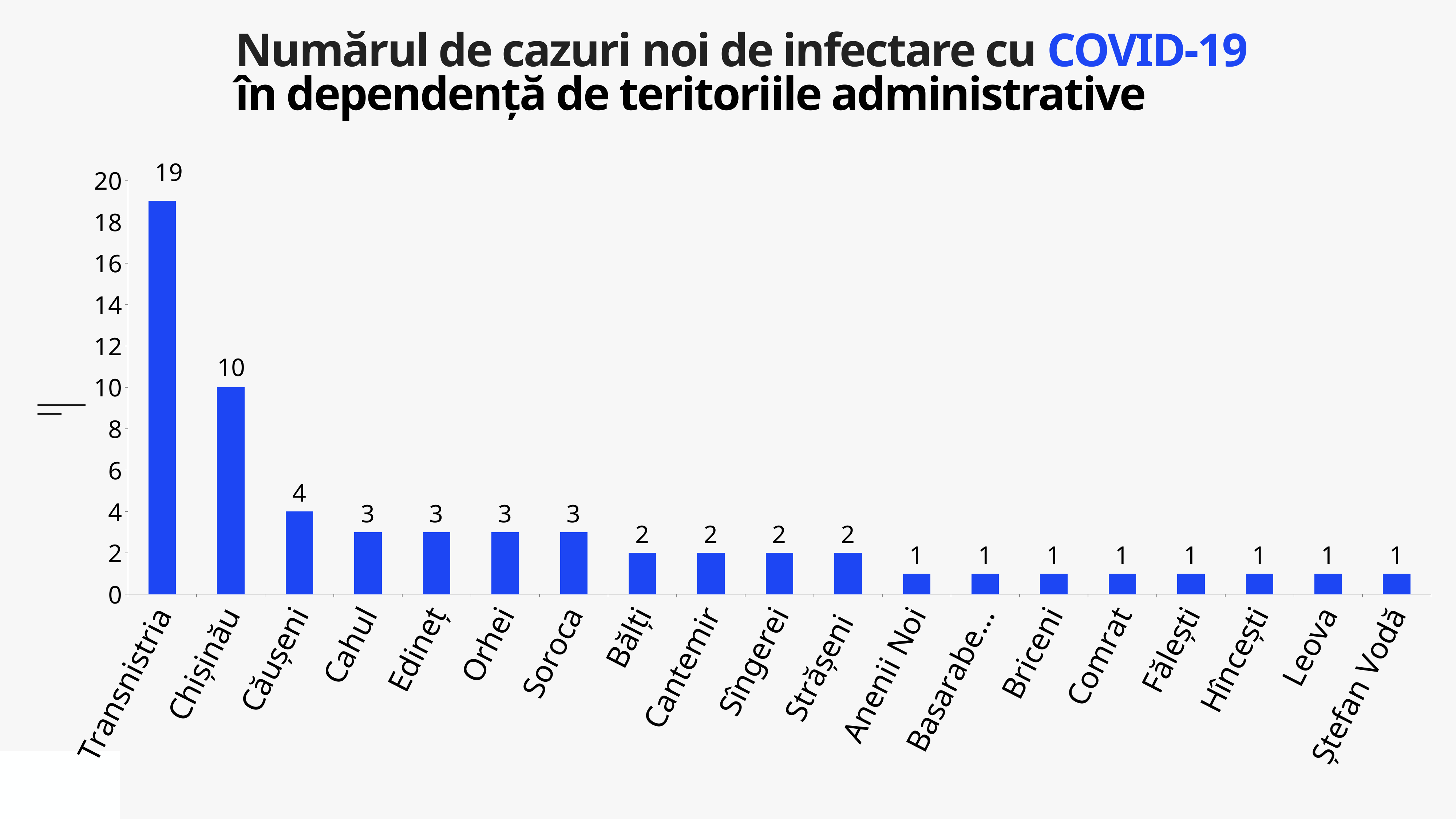
What kind of chart is shown on the slide? Bar chart What is the difference between the values for Transnistria and Chișinău? 9 Do the values rise or fall from left to right along the x axis? Fall Which is larger, the value for Cahul or the value for Bălți? Cahul What is the value for Strășeni? 2 Which territory has the highest number of new cases? Transnistria What is the value for Căușeni? 4 What is the value for Leova? 1 How many territories are shown on the x axis? 19 What is the value for Chișinău? 10 What is the value for Transnistria? 19 What colour are the bars in the chart? Blue